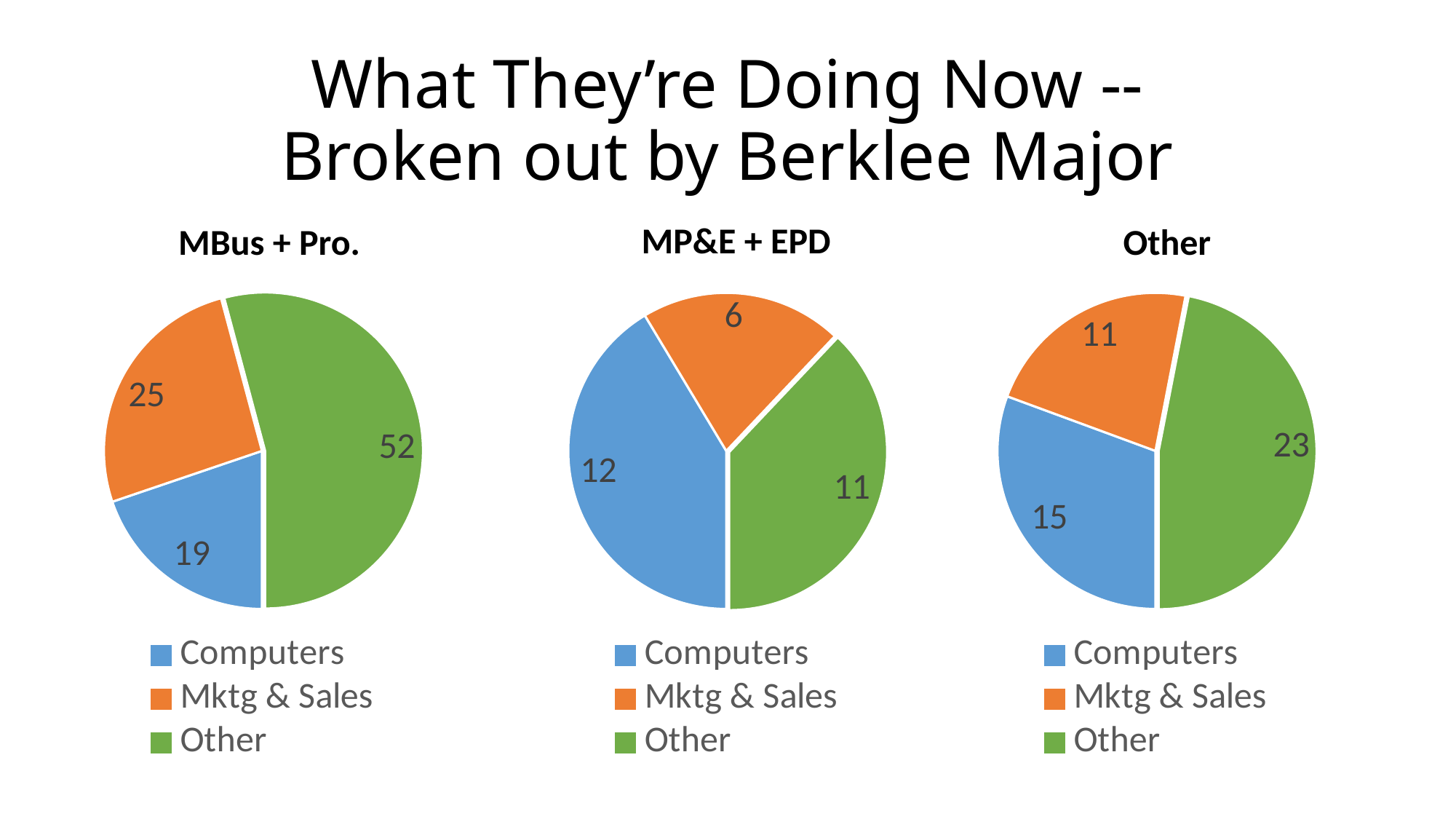
How many entries does the legend of the MBus + Pro. chart list? 3 In the Other chart (rightmost), what is the value for Computers? 15 In the Other chart (rightmost), which category has the smallest slice? Mktg & Sales In the MBus + Pro. chart, what is the value for Other? 52 In the MP&E + EPD chart, which is larger, Computers or Other? Computers How many pie charts are shown on the slide? 3 What type of chart is the MP&E + EPD chart? Pie chart In the MP&E + EPD chart, which category has the smallest slice? Mktg & Sales In the Other chart (rightmost), what is the total of all three slices? 49 In the MBus + Pro. chart, which category has the largest slice? Other In the MBus + Pro. chart, what is the difference between Other and Mktg & Sales? 27 In the MP&E + EPD chart, what is the value for Mktg & Sales? 6